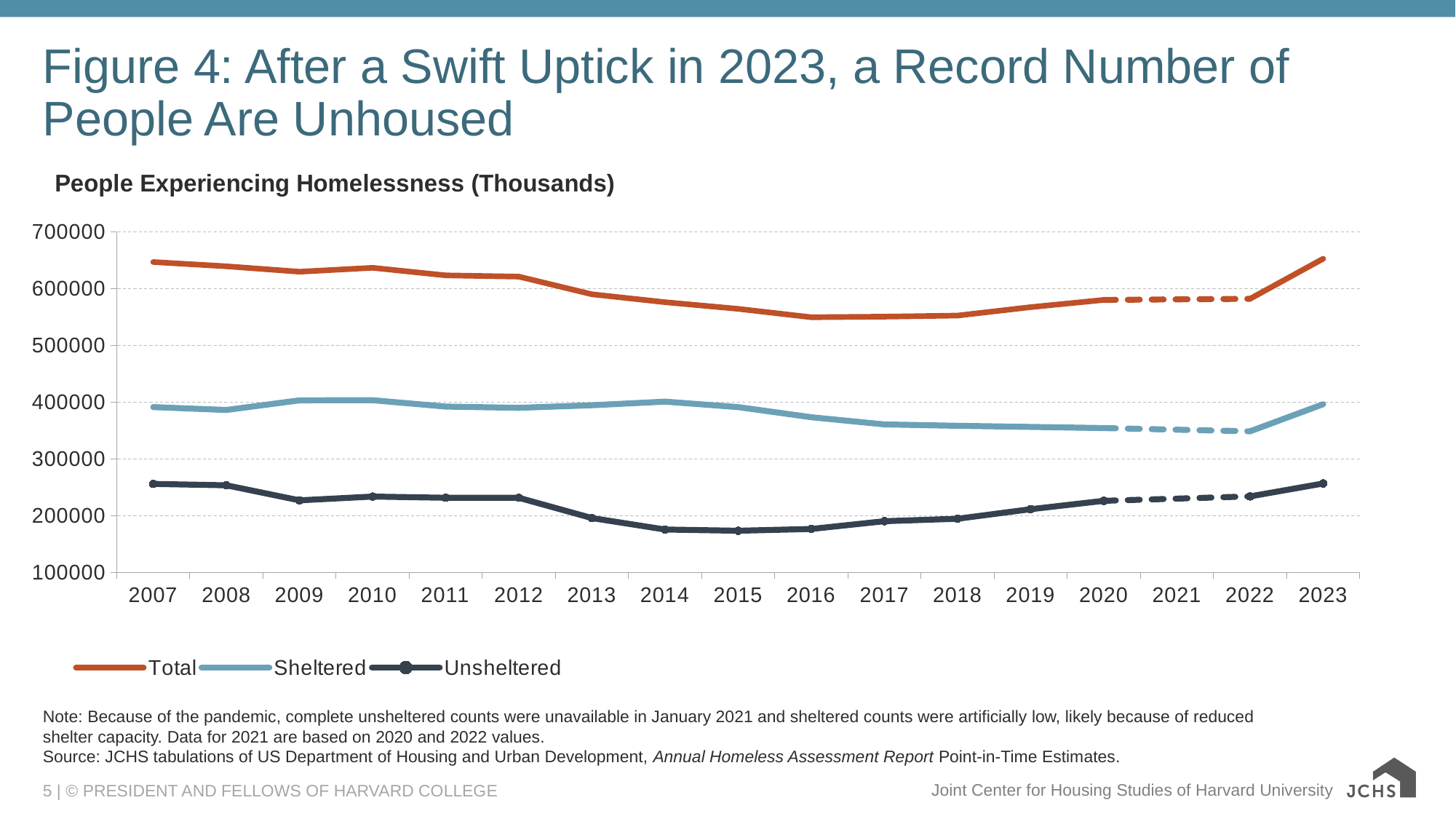
Is the value for Sheltered in 2017 greater or less than 400000? less Which is larger, the Unsheltered value in 2008 or the Unsheltered value in 2015? 2008 How many series does the legend list? 3 Is the value for Unsheltered in 2014 greater or less than 200000? less Is the value for Total in 2007 greater or less than 600000? greater What kind of chart is shown on the slide? Line chart How many years are plotted along the x axis? 17 Does the Total series rise or fall from 2007 to 2016? Falls Which is larger, the Total value in 2012 or the Total value in 2016? 2012 Which series is drawn in orange? Total Does the Total series rise or fall from 2016 to 2023? Rises